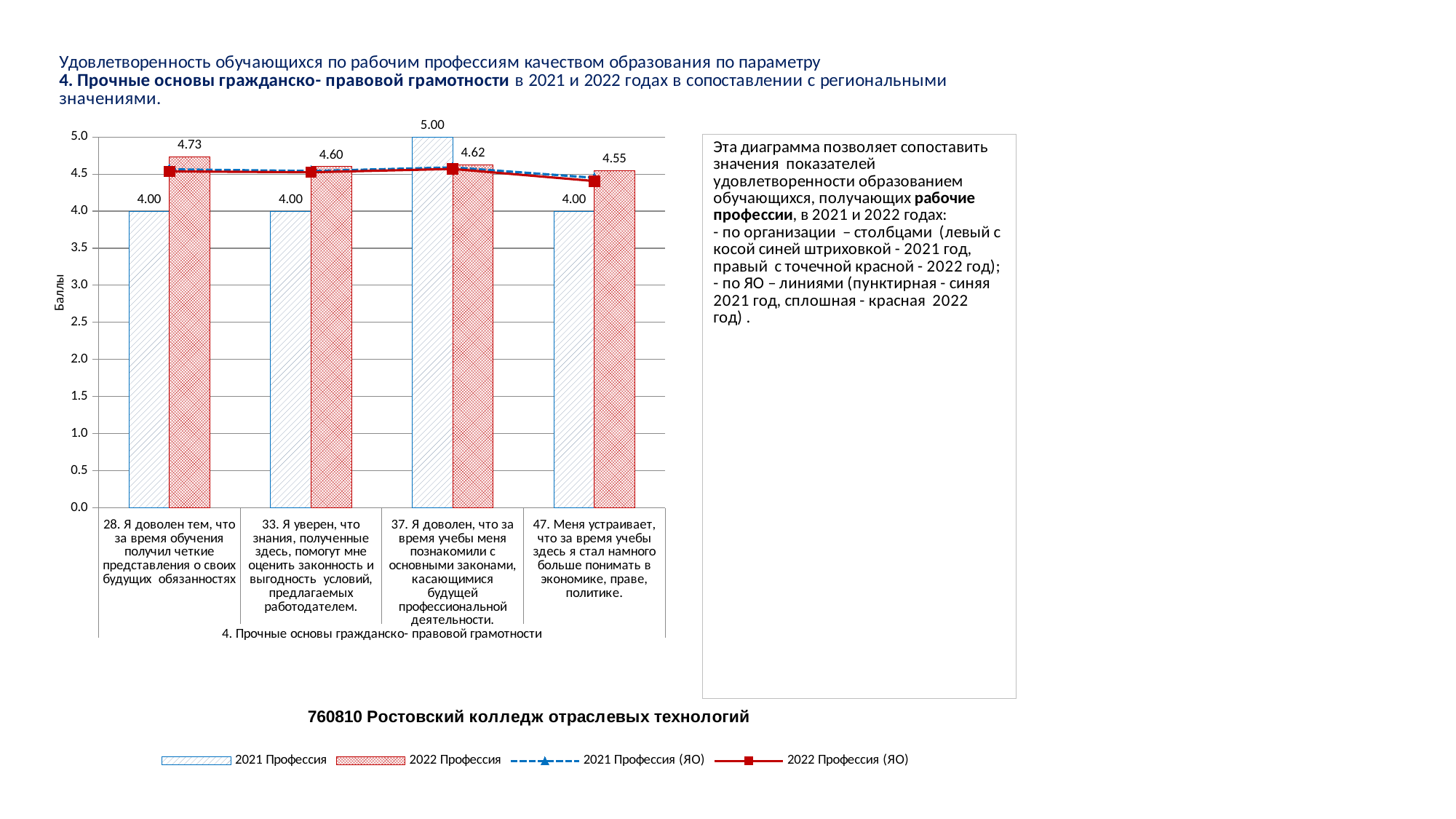
What type of chart is shown on the slide? Bar chart with line series Which question has the highest 2022 Профессия value? 28. Я доволен тем, что за время обучения получил четкие представления о своих будущих обязанностях What is the 2022 Профессия value for question 47 (Меня устраивает, что за время учебы здесь я стал намного больше понимать в экономике, праве, политике)? 4.55 What is the difference between the 2021 Профессия and 2022 Профессия values for question 33? 0.60 Which question has the lowest 2022 Профессия value? 47. Меня устраивает, что за время учебы здесь я стал намного больше понимать в экономике, праве, политике Is the 2022 Профессия (ЯО) value for question 47 greater or less than 4.5? less What is the 2022 Профессия value for question 28 (Я доволен тем, что за время обучения получил четкие представления о своих будущих обязанностях)? 4.73 What is the label of the y axis? Баллы How many categories (questions) are shown on the x axis? 4 What is the 2021 Профессия value for question 37 (Я доволен, что за время учебы меня познакомили с основными законами)? 5.00 For question 37, which is larger: the 2021 Профессия value or the 2022 Профессия value? 2021 Профессия How many series does the legend list? 4